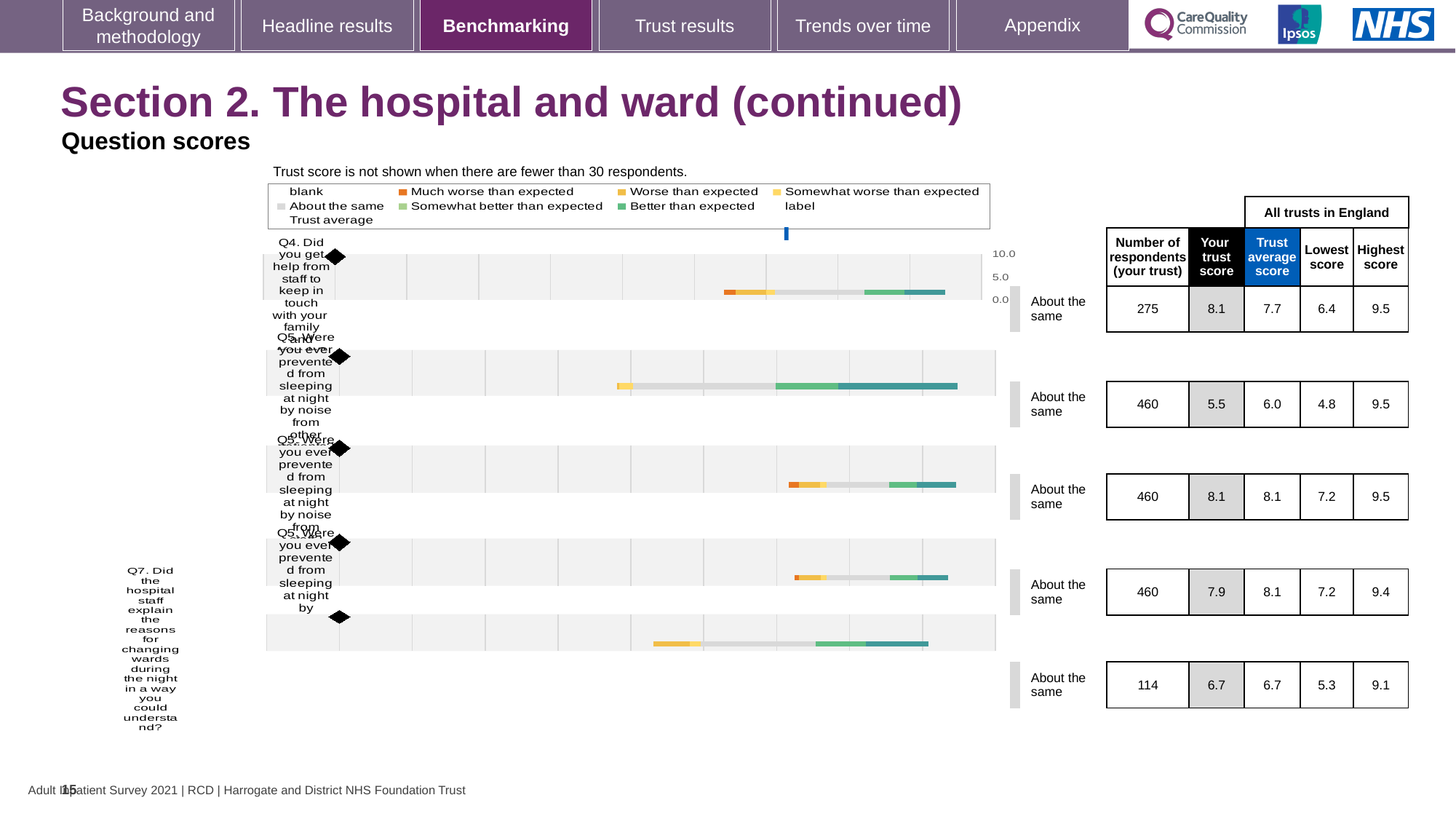
For Q4 (help from staff to keep in touch with family and friends), which is larger: the trust's own score or the trust average score? Your trust score What is the 'Your trust score' for Q4 (help from staff to keep in touch with family and friends)? 8.1 Which question row has the fewest respondents from the trust? Q7 (explaining reasons for changing wards during the night), 114 How many question rows are plotted in the chart? 5 What is the highest score across all trusts in England for Q7 (explaining reasons for changing wards during the night)? 9.1 What is the trust average score for Q4 (help from staff to keep in touch with family and friends)? 7.7 Is the trust score marker for Q4 (help from staff to keep in touch with family and friends) greater or less than 5.0 on the chart axis? greater How many respondents from the trust answered Q4 (help from staff to keep in touch with family and friends)? 275 What is the difference between the highest and lowest scores across all trusts in England for Q4 (help from staff to keep in touch with family and friends)? 3.1 What benchmark category is shown for every question row on this slide? About the same Which question row has the lowest 'Your trust score'? The second row (460 respondents, score 5.5) What kind of chart is used to show the question scores on this slide? bar chart